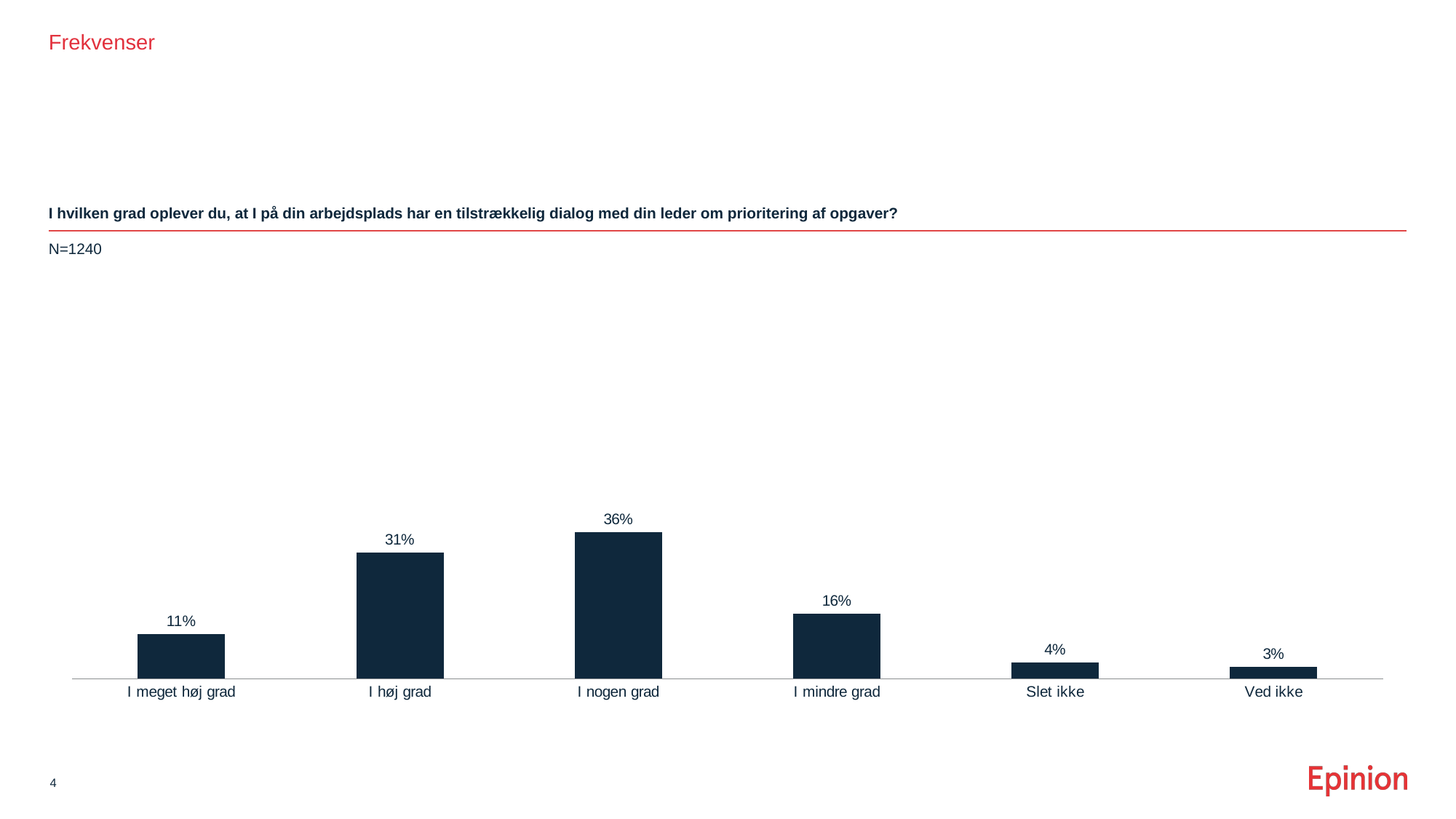
How many categories are shown on the x axis? 6 Which category has the lowest value? Ved ikke What is the value for "I meget høj grad"? 11% What kind of chart is shown on the slide? Bar chart What is the sample size (N) stated above the chart? N=1240 What is the difference between the values for "I nogen grad" and "I høj grad"? 5% Which is larger, the value for "I høj grad" or the value for "I mindre grad"? I høj grad What is the value for "I nogen grad"? 36% What is the value for "I mindre grad"? 16% Which category has the highest value? I nogen grad What is the value for "Slet ikke"? 4% What is the difference between the values for "I mindre grad" and "I meget høj grad"? 5%